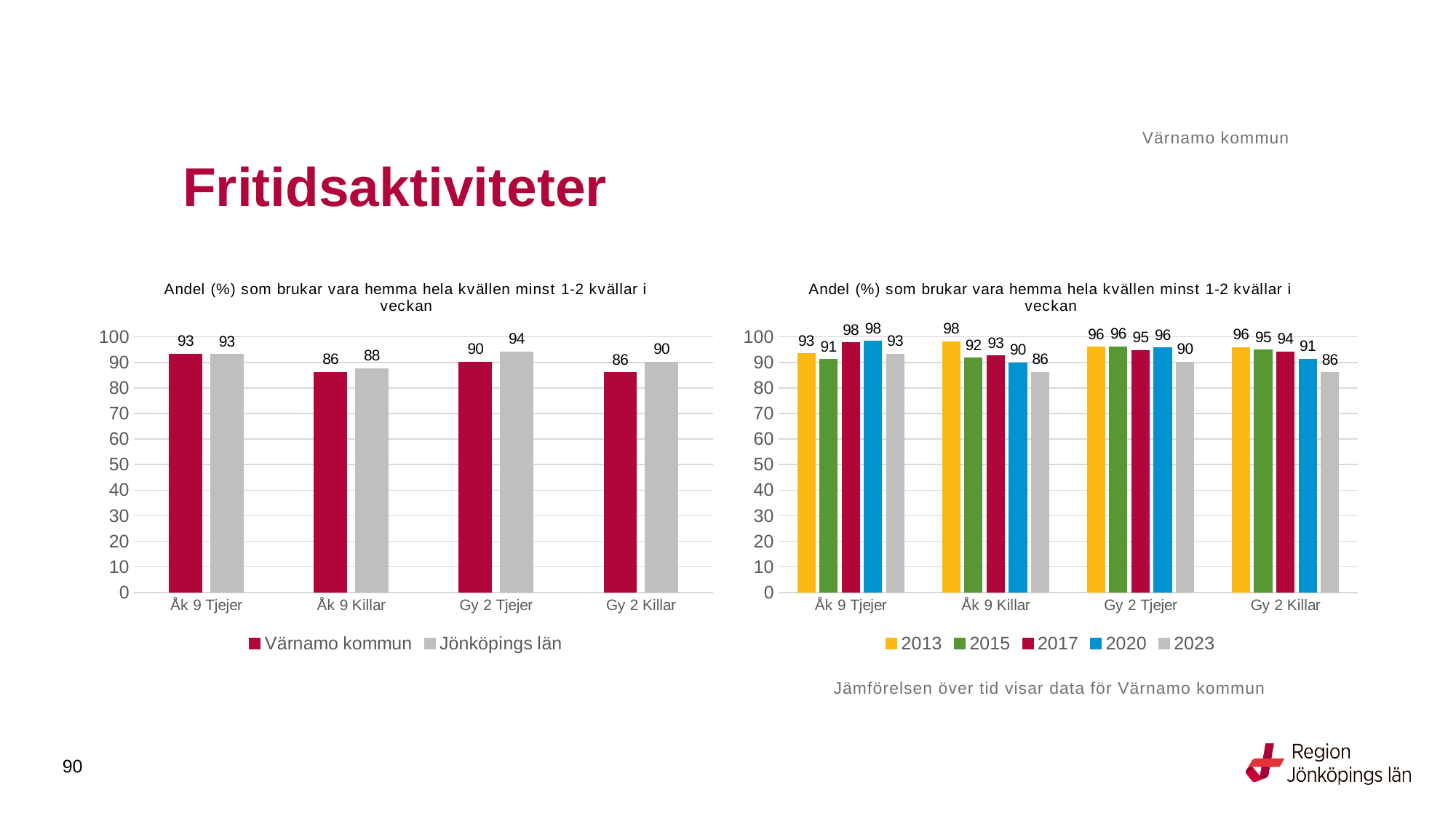
In the right chart, how many series does the legend list? 5 In the left chart, what is the difference between Jönköpings län and Värnamo kommun for Gy 2 Killar? 4 In the right chart, what is the value for 2020 for Gy 2 Killar? 91 What type of chart is the left chart? bar chart In the right chart, which year has the highest value for Åk 9 Tjejer? 2017 and 2020 In the left chart, how many series does the legend list? 2 In the right chart, what is the difference between the 2013 and 2023 values for Gy 2 Killar? 10 In the left chart, what is the value for Värnamo kommun for Gy 2 Tjejer? 90 In the right chart, what is the value for 2013 for Åk 9 Killar? 98 In the right chart, is the 2023 value for Åk 9 Killar larger or smaller than the 2013 value for Åk 9 Killar? smaller In the left chart, which category has the lowest value for Jönköpings län? Åk 9 Killar In the left chart, what is the value for Jönköpings län for Åk 9 Killar? 88